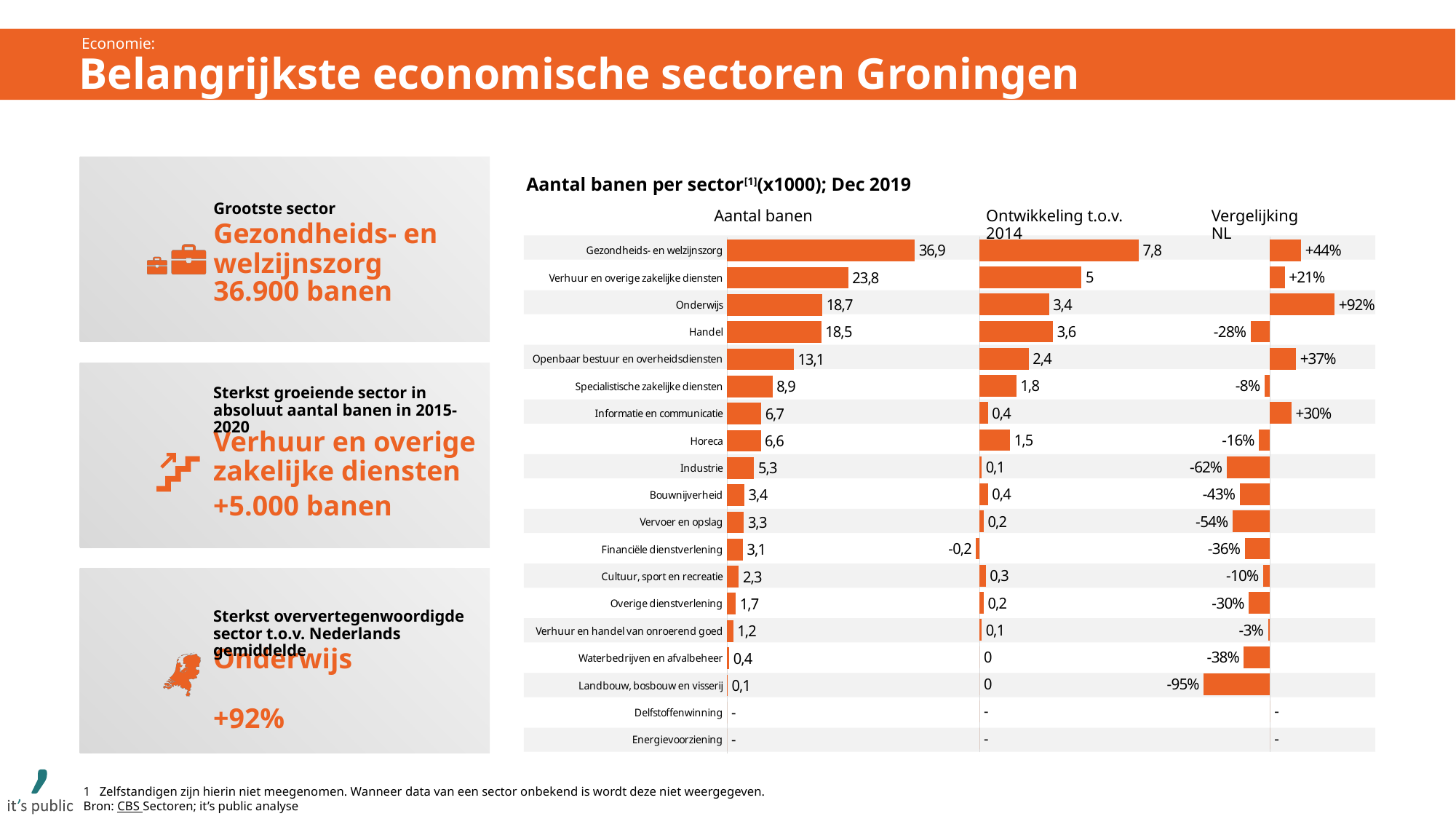
What is the difference in 'Aantal banen' between Gezondheids- en welzijnszorg and Verhuur en overige zakelijke diensten? 13,1 In the 'Ontwikkeling t.o.v. 2014' column, what is the value for Handel? 3,6 What is the title of the chart? Aantal banen per sector (x1000); Dec 2019 What type of chart is used to show the data? Bar chart Which sector has the highest value in the 'Vergelijking NL' column? Onderwijs In the 'Vergelijking NL' column, what is the value for Industrie? -62% Which sector has a negative value in the 'Ontwikkeling t.o.v. 2014' column? Financiële dienstverlening Which sector has the highest value in the 'Aantal banen' column? Gezondheids- en welzijnszorg How many sectors are listed in the chart? 19 In the 'Aantal banen' column, what is the value for Onderwijs? 18,7 Which sector has the lowest value in the 'Vergelijking NL' column? Landbouw, bosbouw en visserij In the 'Aantal banen' column, which is larger: Onderwijs or Handel? Onderwijs